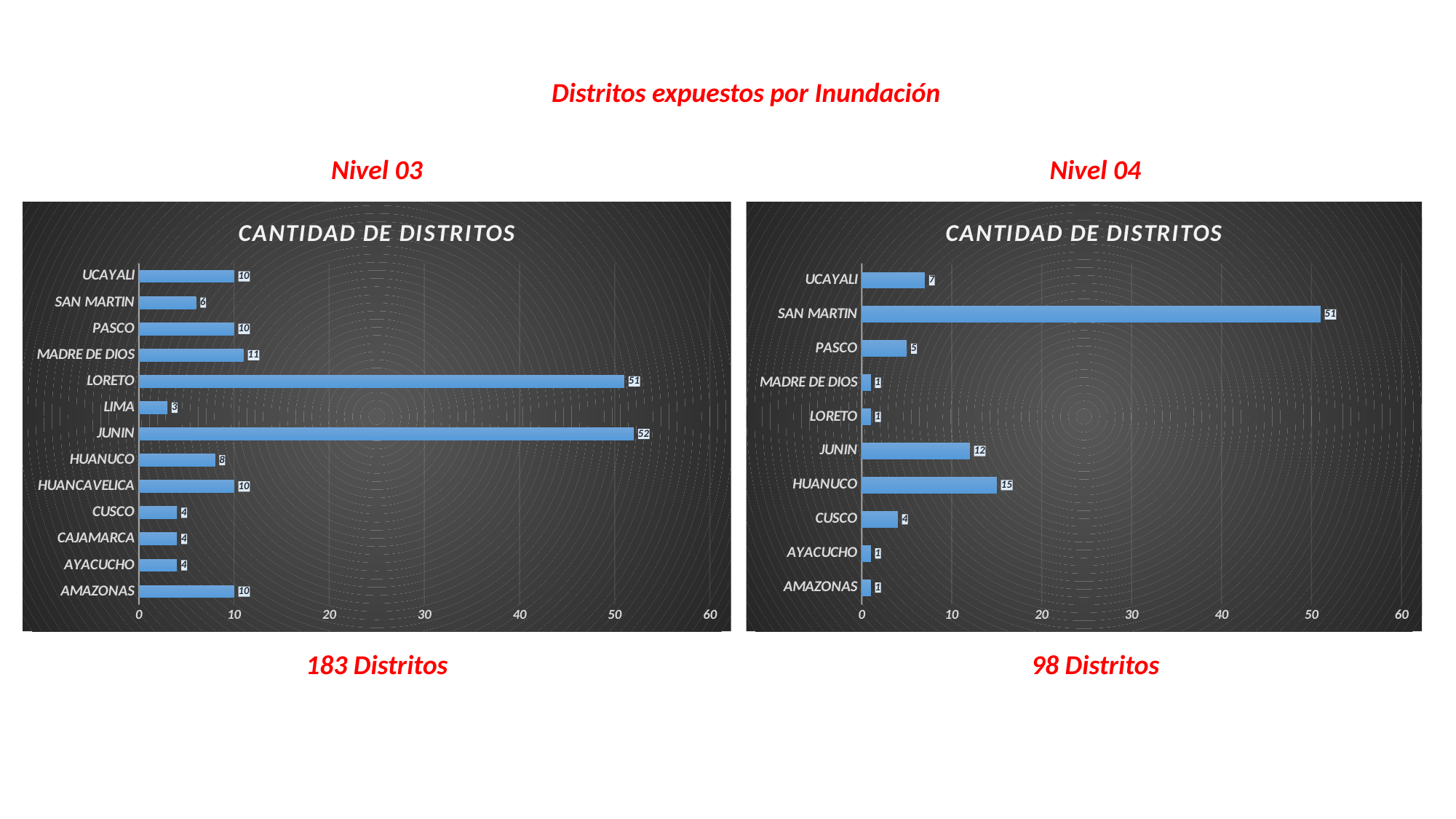
In the Nivel 04 chart (right), how many districts are shown for HUANUCO? 15 How many regions are listed in the Nivel 03 chart (left)? 13 In the Nivel 04 chart (right), which region has the highest number of districts? SAN MARTIN How many regions are listed in the Nivel 04 chart (right)? 10 In the Nivel 03 chart (left), what is the difference between the values for JUNIN and LORETO? 1 In the Nivel 03 chart (left), how many districts are shown for LORETO? 51 What type of chart is used for the Nivel 04 chart (right)? Bar chart In the Nivel 03 chart (left), is the value for MADRE DE DIOS greater or less than 10? greater In the Nivel 04 chart (right), which is larger, the value for UCAYALI or the value for PASCO? UCAYALI In the Nivel 03 chart (left), which region has the lowest number of districts? LIMA In the Nivel 04 chart (right), what is the difference between the values for SAN MARTIN and JUNIN? 39 In the Nivel 03 chart (left), which region has the highest number of districts? JUNIN